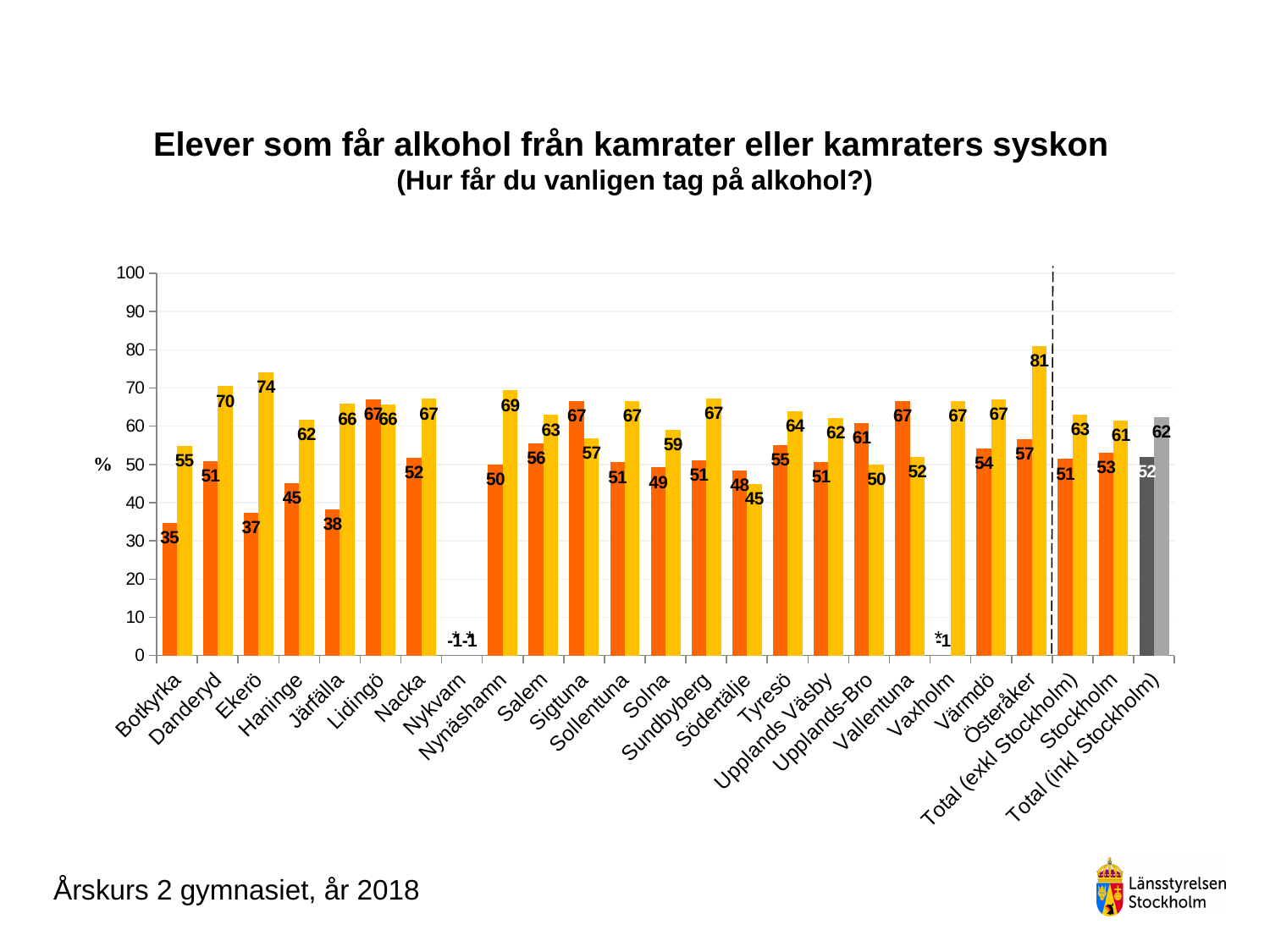
Is the value of the yellow bar for Danderyd greater or less than 60? greater What is the value of the yellow bar for Österåker? 81 Which municipality has the highest yellow bar? Österåker Which municipality has the lowest orange bar among those with a plotted value? Botkyrka For Sigtuna, which is larger: the orange bar or the yellow bar? the orange bar What kind of chart is shown on the slide? bar chart What is the difference between the yellow bar and the orange bar for Ekerö? 37 What is the value of the yellow bar for Ekerö? 74 What is the value of the orange bar for Total (exkl Stockholm)? 51 What is the value of the light grey bar for Total (inkl Stockholm)? 62 What is the value of the orange bar for Botkyrka? 35 What is the title of the chart? Elever som får alkohol från kamrater eller kamraters syskon